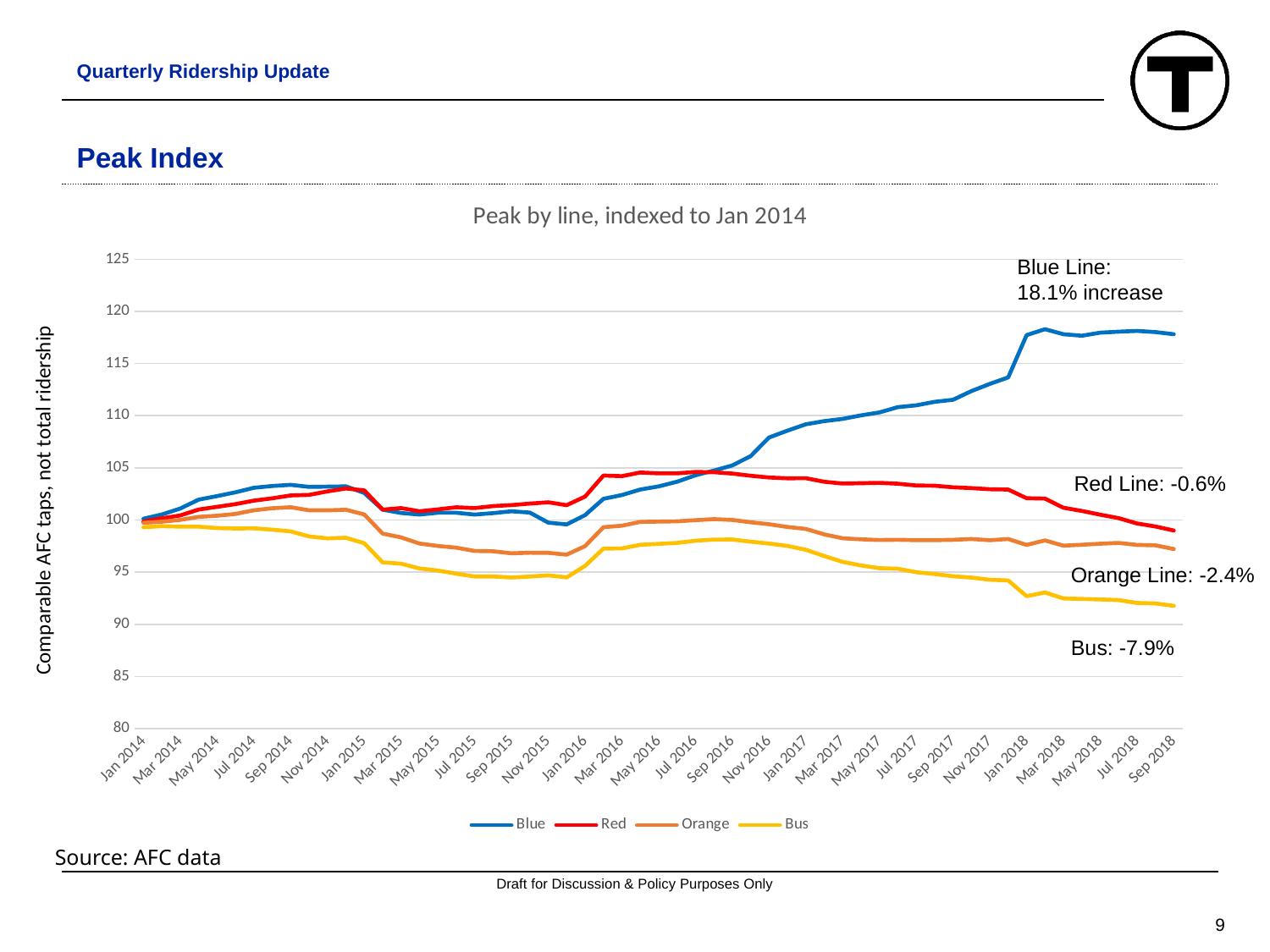
According to the annotation on the chart, what is the percentage change for the Red Line? -0.6% Does the Blue series generally rise or fall from Jan 2014 to Sep 2018? rise What kind of chart is shown on the slide? line chart What is the title of the chart? Peak by line, indexed to Jan 2014 Is the value for Bus at Sep 2018 greater or less than 95? less Is the value for Blue at Sep 2018 greater or less than 115? greater According to the annotation on the chart, what is the percentage change for the Blue Line? 18.1% increase How many series does the legend list? 4 According to the annotation on the chart, what is the percentage change for Bus? -7.9% Which series has the lowest value at Sep 2018? Bus What is the label on the vertical axis of the chart? Comparable AFC taps, not total ridership Which series has the highest value at Sep 2018? Blue